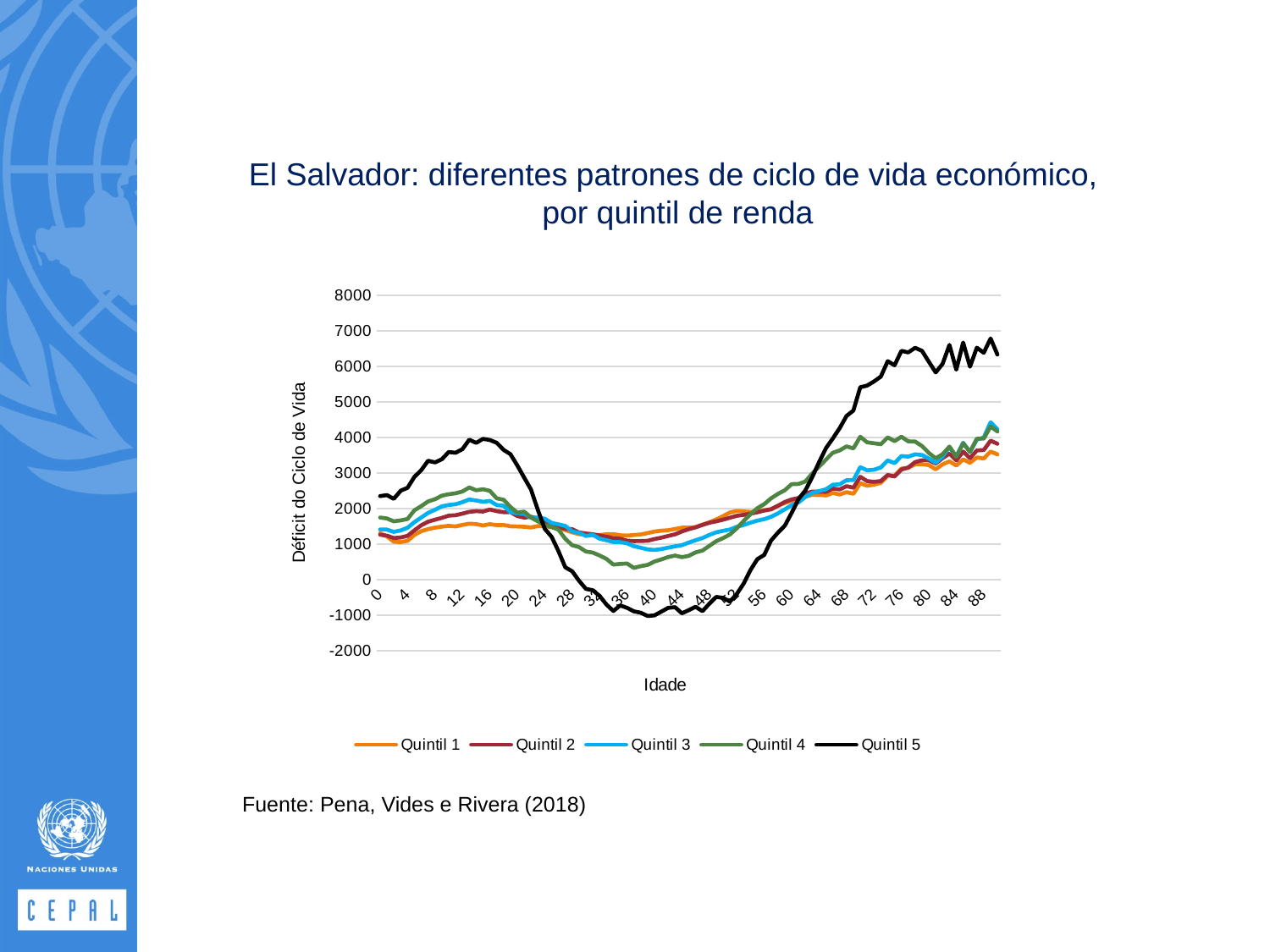
Which series reaches the highest value on the chart? Quintil 5 At age 40, which is larger: Quintil 1 or Quintil 4? Quintil 1 Is the value for Quintil 5 at age 40 greater or less than 0? less Is the value for Quintil 5 at age 72 greater or less than 5000? greater Is the value for Quintil 4 at age 36 greater or less than 1000? less What kind of chart is shown on the slide? line chart What is the label of the vertical axis? Déficit do Ciclo de Vida Does the Quintil 5 line rise or fall between age 16 and age 40? fall How many series does the legend list? 5 At age 12, which is larger: Quintil 4 or Quintil 1? Quintil 4 Which series reaches the lowest value on the chart? Quintil 5 What are the series names listed in the legend? Quintil 1, Quintil 2, Quintil 3, Quintil 4, Quintil 5